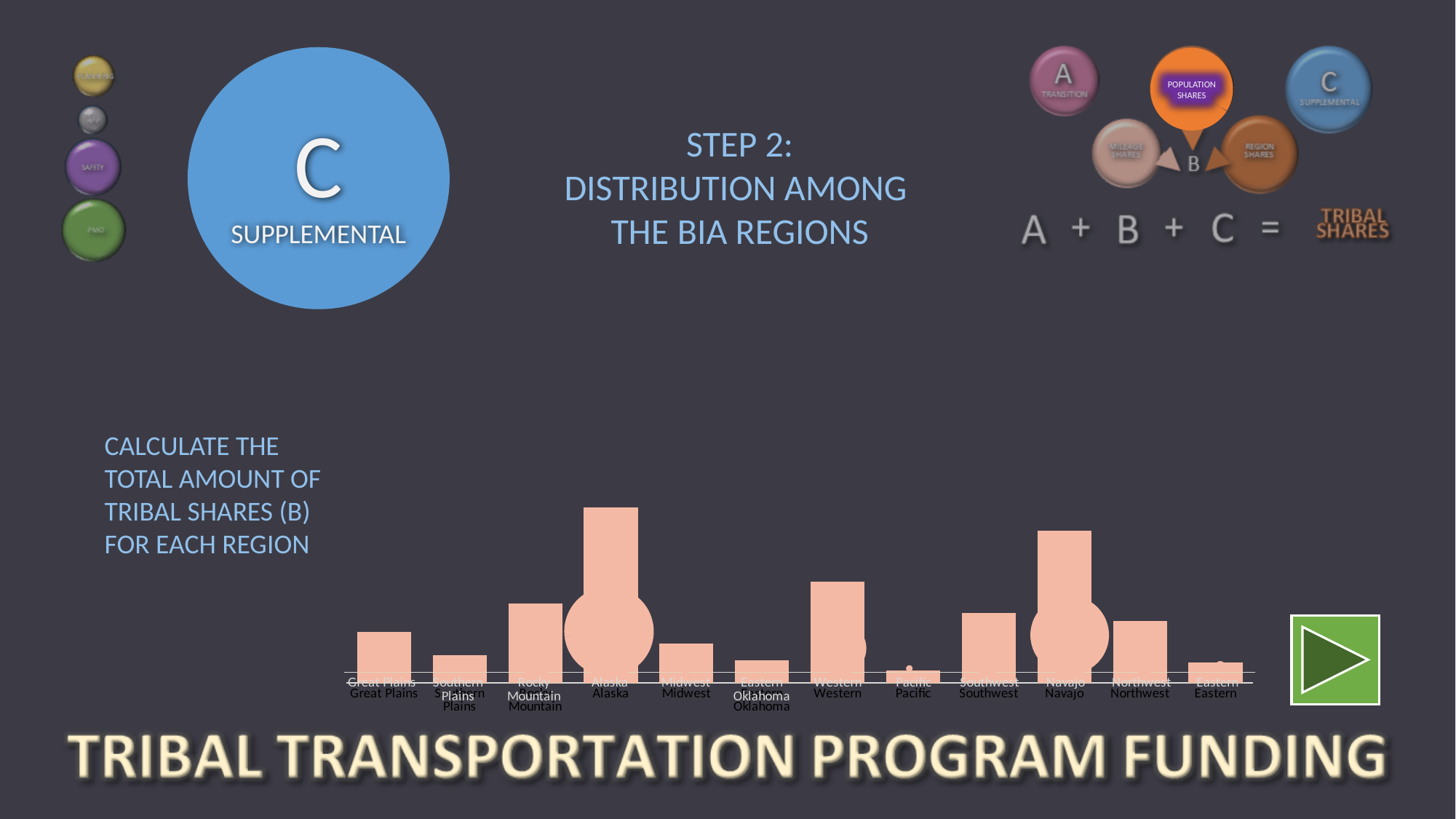
Which bar is taller, Eastern or Pacific? Eastern Which bar is taller, Midwest or Eastern Oklahoma? Midwest Which region has the shortest bar in the chart? Pacific Which bar is taller, Western or Southwest? Western Which region has the tallest bar in the chart? Alaska Which region has the second tallest bar in the chart? Navajo What kind of chart is shown on the slide? bar chart Which region is the last category on the right of the x axis? Eastern Which region is the first category on the left of the x axis? Great Plains How many regions are shown along the x axis of the bar chart? 12